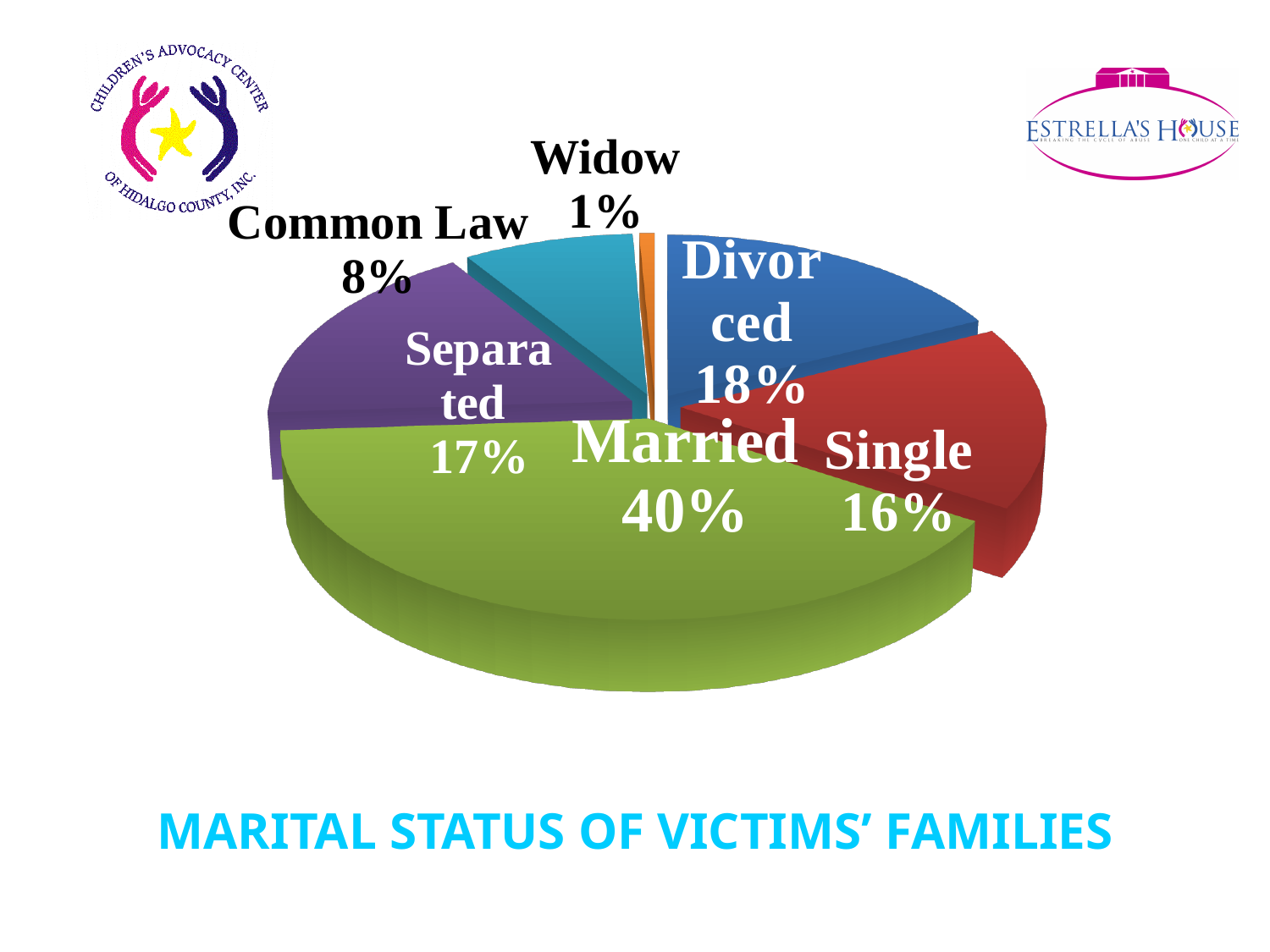
What kind of chart is shown on the slide? Pie chart What colour is the Married slice of the pie chart? Green What is the difference in percentage points between Married and Single? 24 What percentage of victims' families are Married? 40% What percentage of victims' families are Common Law? 8% Which is larger, the share for Divorced or the share for Common Law? Divorced How many marital status categories are shown in the pie chart? 6 Which marital status category has the smallest share? Widow What percentage of victims' families are Separated? 17% Which marital status category has the largest share? Married What percentage of victims' families are Divorced? 18% What is the title of the chart? MARITAL STATUS OF VICTIMS' FAMILIES